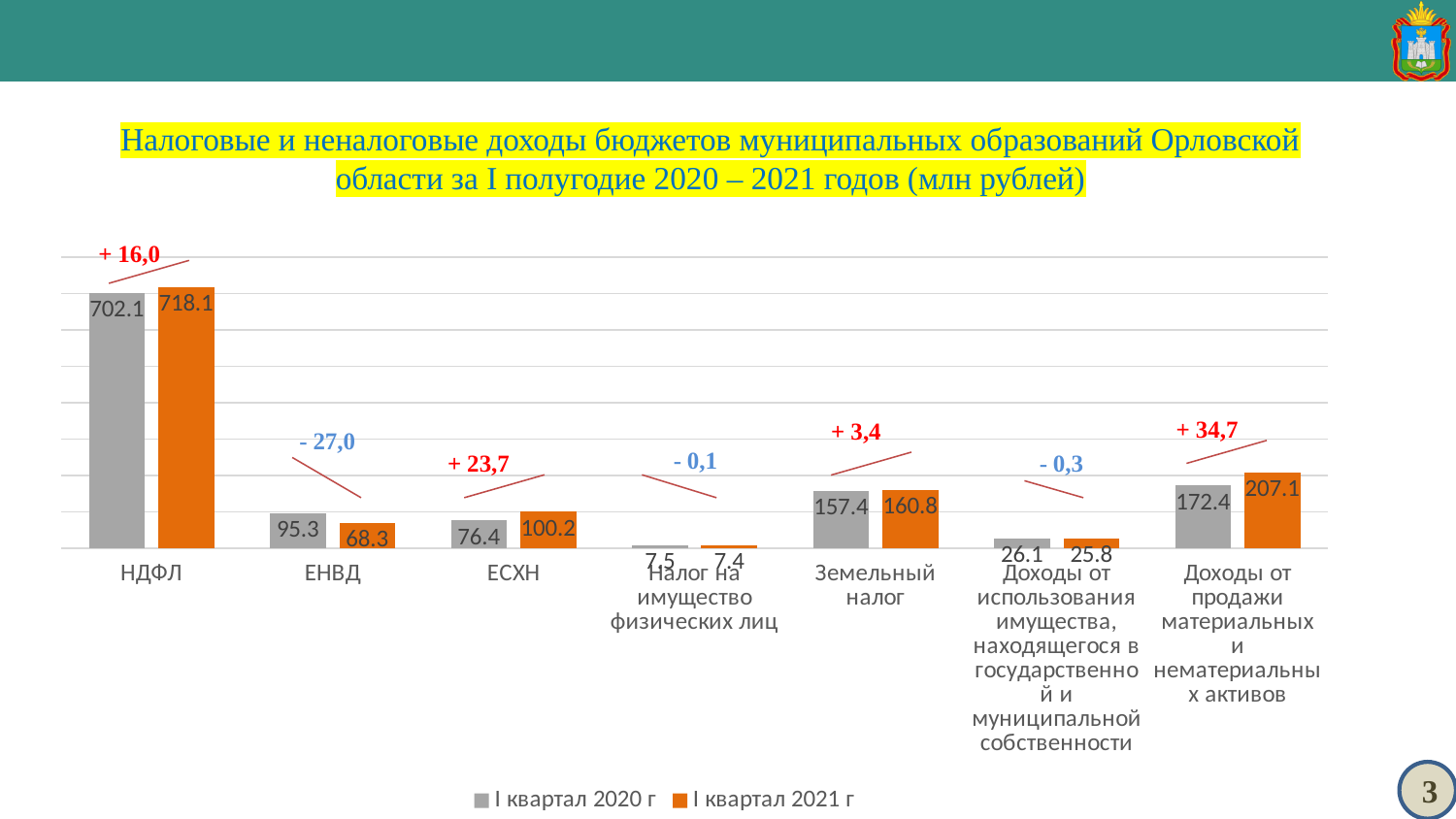
What change is annotated above the bars for ЕСХН? + 23,7 How many series does the legend list? 2 What is the value for Земельный налог in the I квартал 2021 г series? 160.8 What is the value for НДФЛ in the I квартал 2020 г series? 702.1 What is the difference between the I квартал 2021 г and I квартал 2020 г values for ЕНВД? 27.0 What kind of chart is shown on the slide? bar chart How many categories are shown on the x axis of the chart? 7 Which category has the highest value in the I квартал 2021 г series? НДФЛ Which is larger for Доходы от продажи материальных и нематериальных активов: the I квартал 2020 г value or the I квартал 2021 г value? I квартал 2021 г Which category has the lowest value in the I квартал 2020 г series? Налог на имущество физических лиц What is the value for ЕСХН in the I квартал 2021 г series? 100.2 Which is larger for ЕНВД: the I квартал 2020 г value or the I квартал 2021 г value? I квартал 2020 г